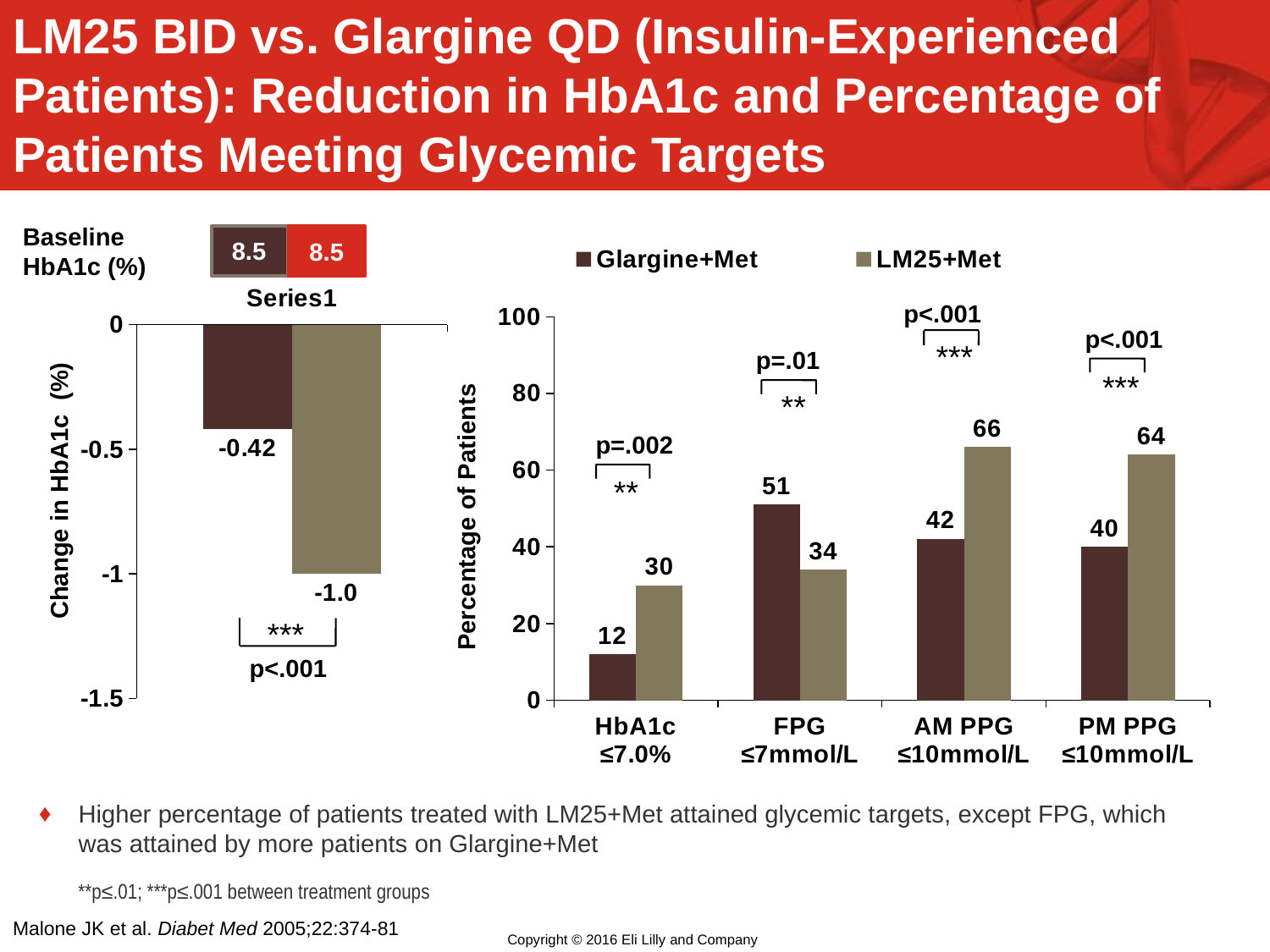
On the right chart (Percentage of Patients), which series has the larger value in the FPG ≤7mmol/L category? Glargine+Met On the right chart (Percentage of Patients), which category has the highest value for LM25+Met? AM PPG ≤10mmol/L On the right chart (Percentage of Patients), how many series does the legend list? 2 On the right chart (Percentage of Patients), what is the value for Glargine+Met in the FPG ≤7mmol/L category? 51 On the right chart (Percentage of Patients), what percentage of Glargine+Met patients met the HbA1c ≤7.0% target? 12 On the right chart (Percentage of Patients), which category has the lowest value for Glargine+Met? HbA1c ≤7.0% What kind of chart is the right chart (Percentage of Patients)? bar chart On the right chart (Percentage of Patients), what is the difference between LM25+Met and Glargine+Met in the PM PPG ≤10mmol/L category? 24 On the left chart (Change in HbA1c), what is the value shown for the tan bar? -1.0 On the right chart (Percentage of Patients), what percentage of LM25+Met patients met the AM PPG ≤10mmol/L target? 66 On the right chart (Percentage of Patients), how many categories are shown on the x axis? 4 On the left chart (Change in HbA1c), what is the value shown for the dark brown bar? -0.42